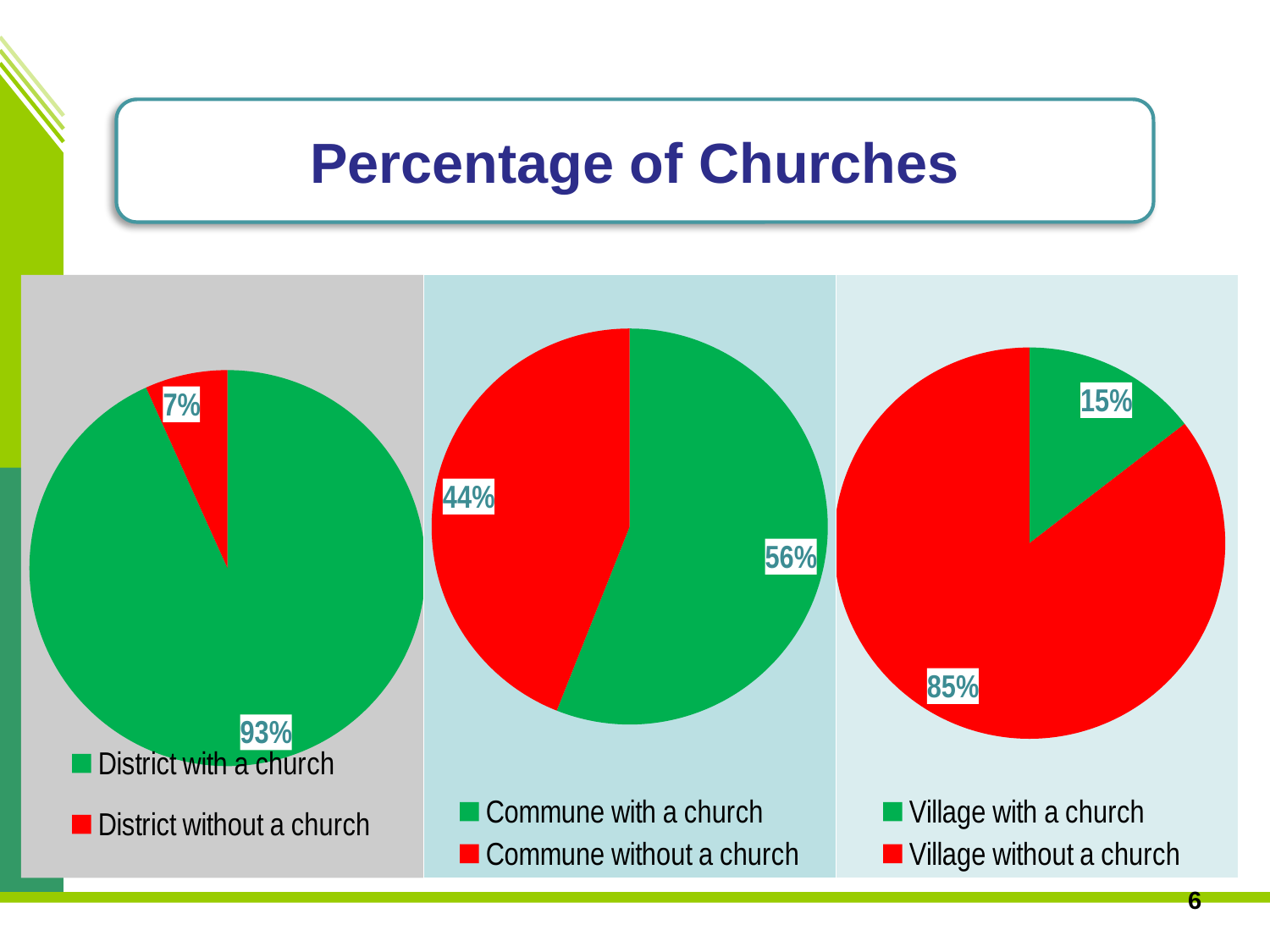
In the left pie chart, which slice is the smallest? District without a church In the right pie chart, what percentage is shown for Village without a church? 85% In the left pie chart, what percentage is shown for District without a church? 7% In the middle pie chart, what percentage is shown for Commune with a church? 56% What kind of chart is used on this slide? Pie chart In the middle pie chart, which is larger: Commune with a church or Commune without a church? Commune with a church In the middle pie chart, what percentage is shown for Commune without a church? 44% How many pie charts are shown on the slide? 3 In the left pie chart, what percentage is shown for District with a church? 93% In the middle pie chart, what is the difference between the Commune with a church and Commune without a church percentages? 12% In the right pie chart, which slice is the largest? Village without a church In the right pie chart, what percentage is shown for Village with a church? 15%